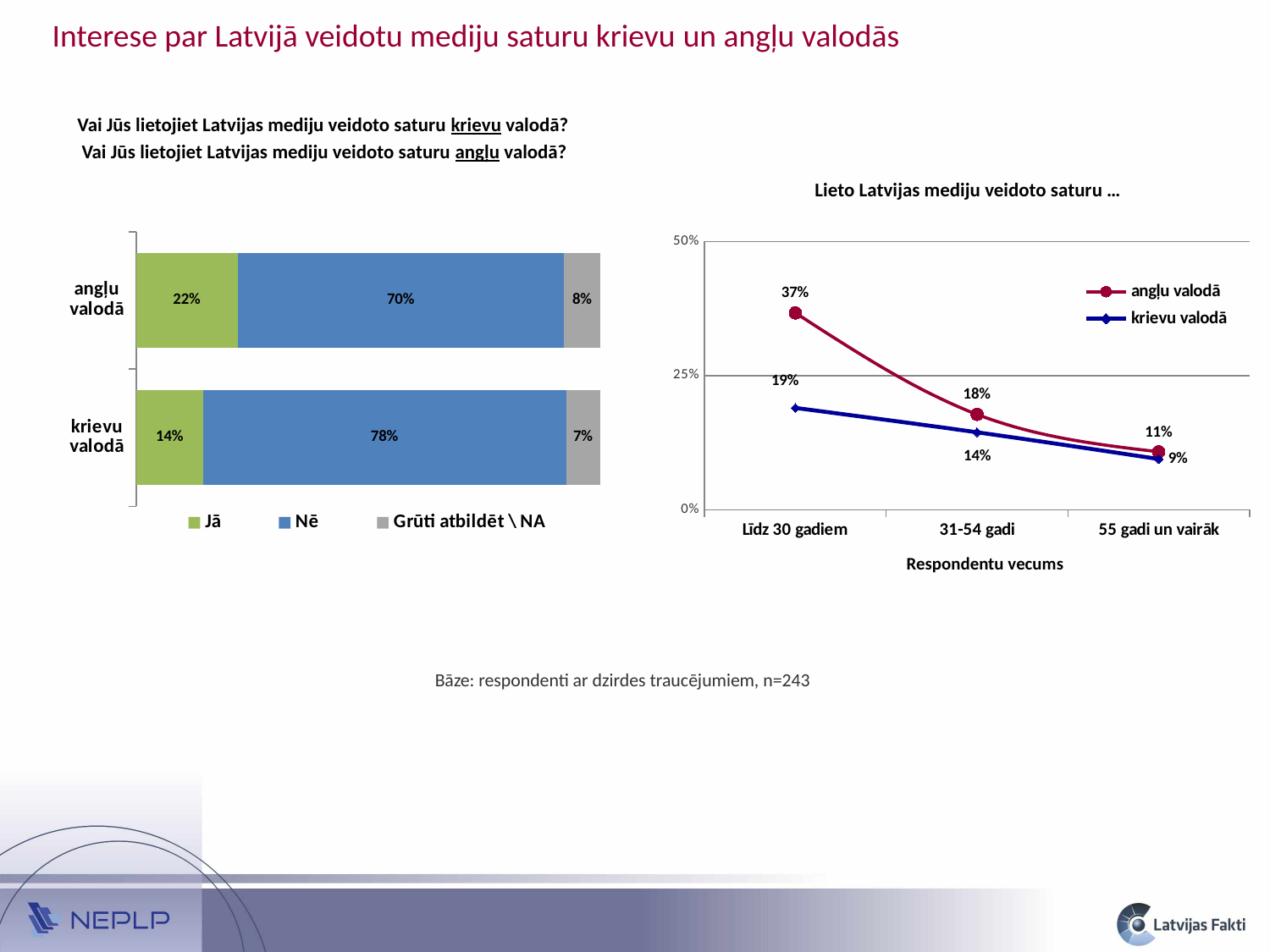
In the left stacked bar chart, what is the difference between the "Nē" shares for krievu valodā and angļu valodā? 8% In the chart "Lieto Latvijas mediju veidoto saturu ...", which age group has the highest value for angļu valodā? Līdz 30 gadiem In the left stacked bar chart, how many series does the legend list? 3 In the chart "Lieto Latvijas mediju veidoto saturu ...", what is the difference between angļu valodā and krievu valodā for 31-54 gadi? 4% What type of chart is the chart titled "Lieto Latvijas mediju veidoto saturu ..."? line chart In the left stacked bar chart, what is the "Grūti atbildēt \ NA" share for angļu valodā? 8% In the chart "Lieto Latvijas mediju veidoto saturu ...", what is the value for angļu valodā for Līdz 30 gadiem? 37% In the left stacked bar chart, what percentage answered "Jā" for angļu valodā? 22% In the chart "Lieto Latvijas mediju veidoto saturu ...", do the values for krievu valodā rise or fall across the age groups? fall In the left stacked bar chart, what percentage answered "Nē" for krievu valodā? 78% In the chart "Lieto Latvijas mediju veidoto saturu ...", what is the value for krievu valodā for 55 gadi un vairāk? 9% In the left stacked bar chart, which language has the larger "Jā" share, angļu valodā or krievu valodā? angļu valodā